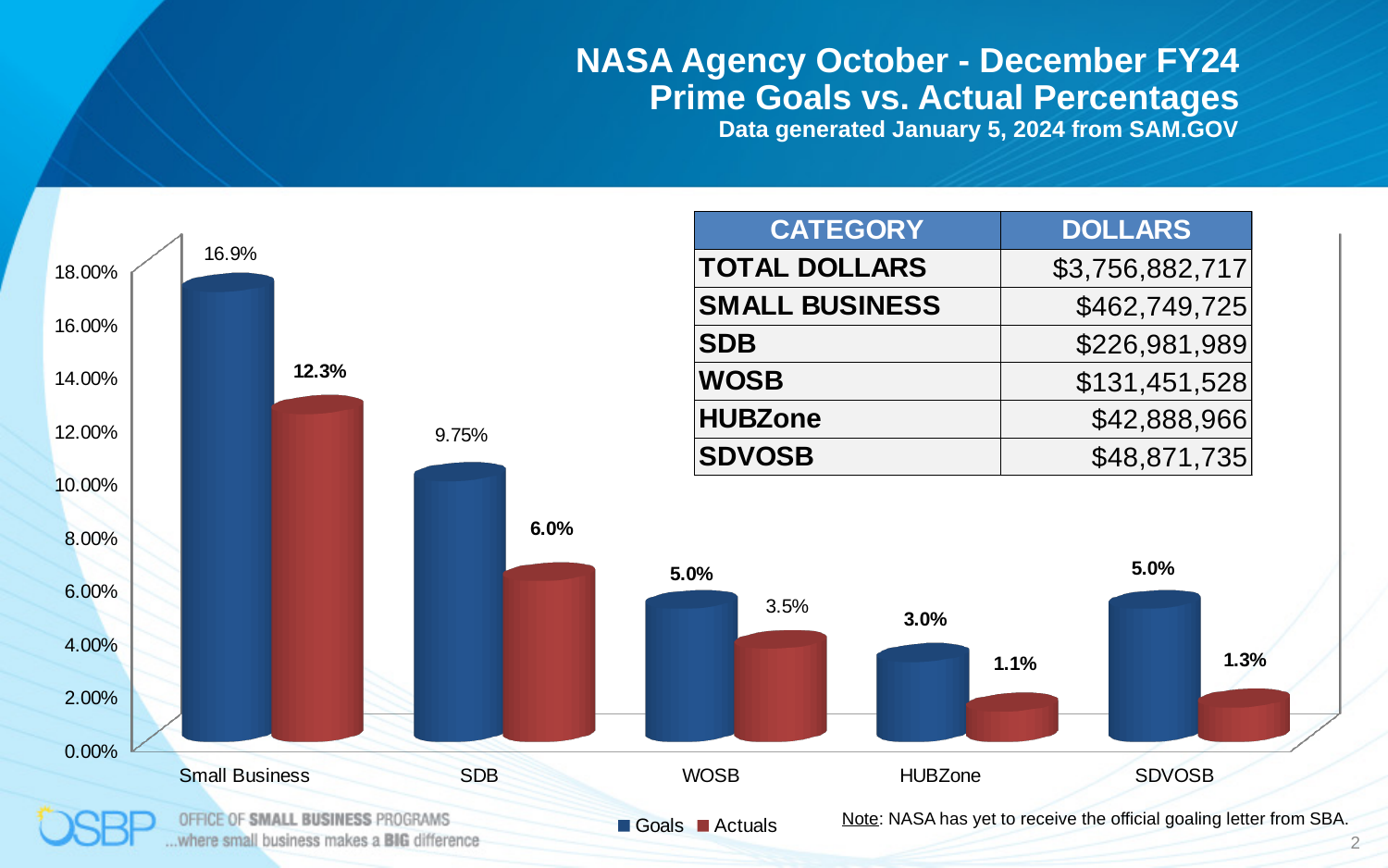
What is the Goals value for Small Business? 16.9% What is the Actuals value for SDB? 6.0% Which category has the highest Actuals value? Small Business Which is larger for WOSB, the Goals value or the Actuals value? Goals What is the difference between the Goals and Actuals values for Small Business? 4.6 percentage points What kind of chart is shown on the slide? Bar chart Which category has the lowest Goals value? HUBZone How many series does the chart legend list? 2 What is the Actuals value for HUBZone? 1.1% How many categories are shown on the x axis of the chart? 5 What is the Actuals value for SDVOSB? 1.3% What is the Goals value for SDB? 9.75%